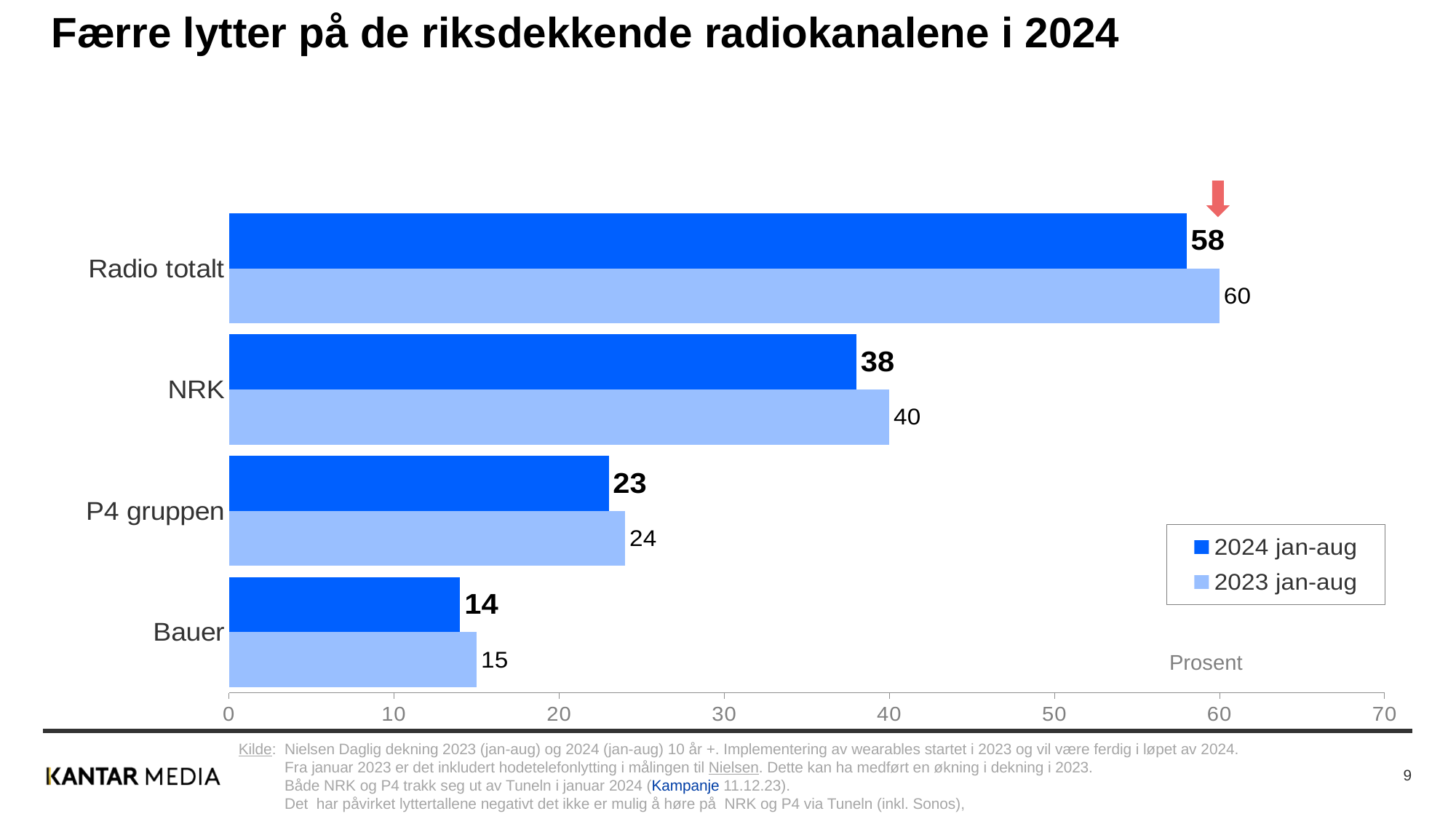
How many series does the legend list? 2 What kind of chart is shown on the slide? Bar chart What is the value for NRK in the 2023 jan-aug series? 40 What is the value for Bauer in the 2023 jan-aug series? 15 How many categories are shown on the chart? 4 Which category has the highest value in the 2023 jan-aug series? Radio totalt What is the difference between the 2023 jan-aug and 2024 jan-aug values for NRK? 2 Which is larger for P4 gruppen: the 2024 jan-aug value or the 2023 jan-aug value? 2023 jan-aug Which category has the lowest value in the 2024 jan-aug series? Bauer What is the value for Radio totalt in the 2024 jan-aug series? 58 What unit label is shown near the x axis of the chart? Prosent What is the value for P4 gruppen in the 2024 jan-aug series? 23